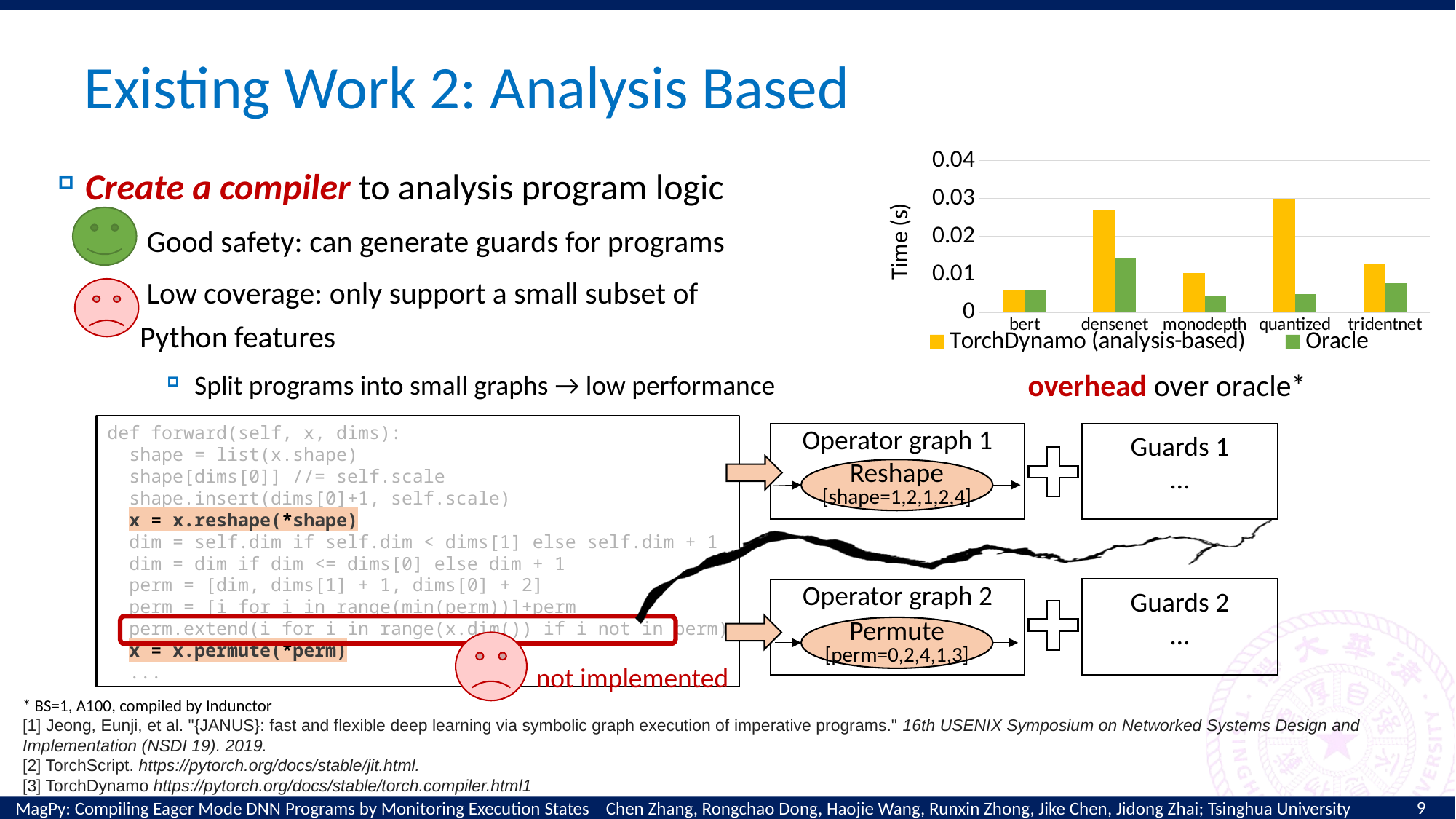
Which series is shown in green in the chart? Oracle What is the label of the chart's y axis? Time (s) What kind of chart is shown on the slide? bar chart For densenet, which is larger: the TorchDynamo (analysis-based) value or the Oracle value? TorchDynamo (analysis-based) Which category has the lowest TorchDynamo (analysis-based) time? bert Which category has the highest TorchDynamo (analysis-based) time? quantized How many categories are shown on the x axis of the chart? 5 Is the TorchDynamo (analysis-based) value for densenet greater or less than 0.02? greater Is the TorchDynamo (analysis-based) value for tridentnet greater or less than 0.01? greater Is the Oracle value for monodepth greater or less than 0.01? less Which category has the highest Oracle time? densenet How many series does the chart's legend list? 2